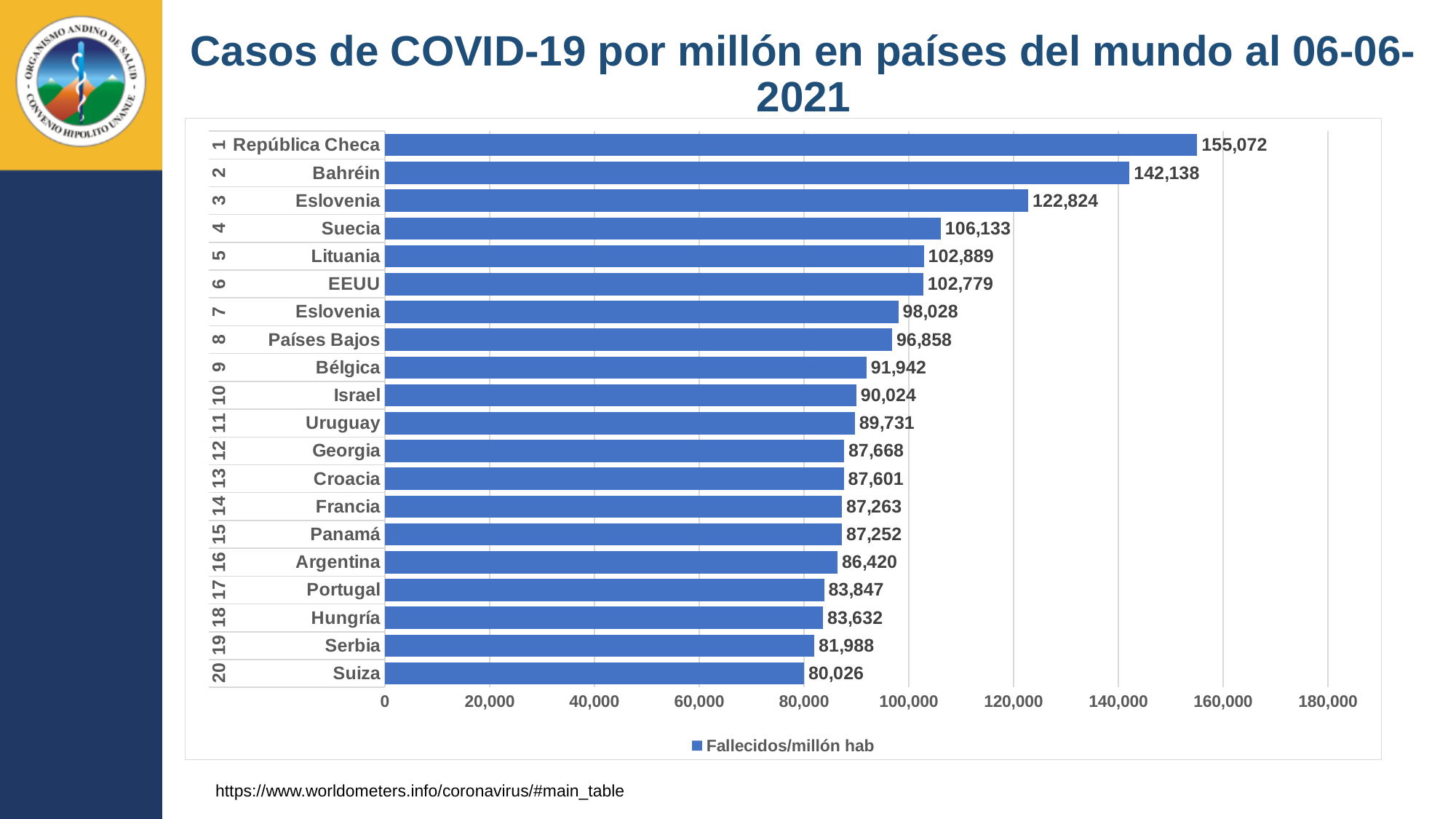
How many countries are shown in the chart? 20 What is the difference between the values for Suecia and Suiza? 26,107 Which country has the lowest value? Suiza What is the value for Suiza? 80,026 What series name does the legend show? Fallecidos/millón hab Which is larger, the value for Israel or the value for Portugal? Israel What is the value for Uruguay? 89,731 What is the difference between the values for República Checa and Bahréin? 12,934 Is the value for Suecia greater or less than 100,000? greater What kind of chart is shown on the slide? Bar chart Which country has the highest value? República Checa What is the value for República Checa? 155,072